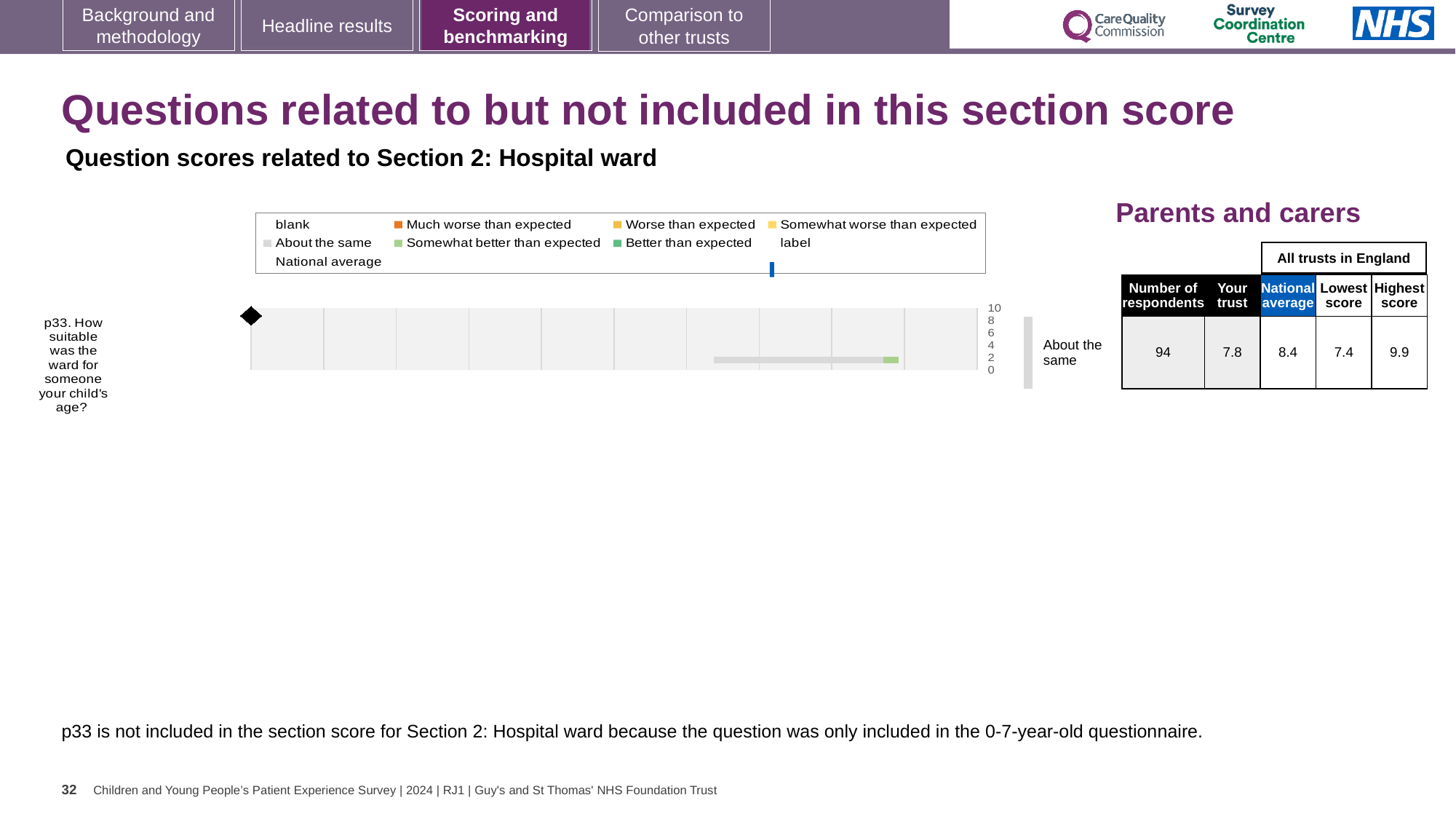
Which benchmarking category is p33 assigned to in the chart? About the same How many respondents answered p33? 94 Is the 'Your trust' score for p33 greater or less than 8? less By how much does the national average exceed the 'Your trust' score for p33? 0.6 What is the difference between the highest and lowest trust scores for p33? 2.5 What is the national average score for p33? 8.4 What is the highest score among all trusts in England for p33? 9.9 What is the 'Your trust' score for p33 (How suitable was the ward for someone your child's age?)? 7.8 What kind of chart is used to show the p33 question score? bar chart What is the lowest score among all trusts in England for p33? 7.4 How many questions are plotted in the chart? 1 Which is larger for p33: the 'Your trust' score or the national average? National average